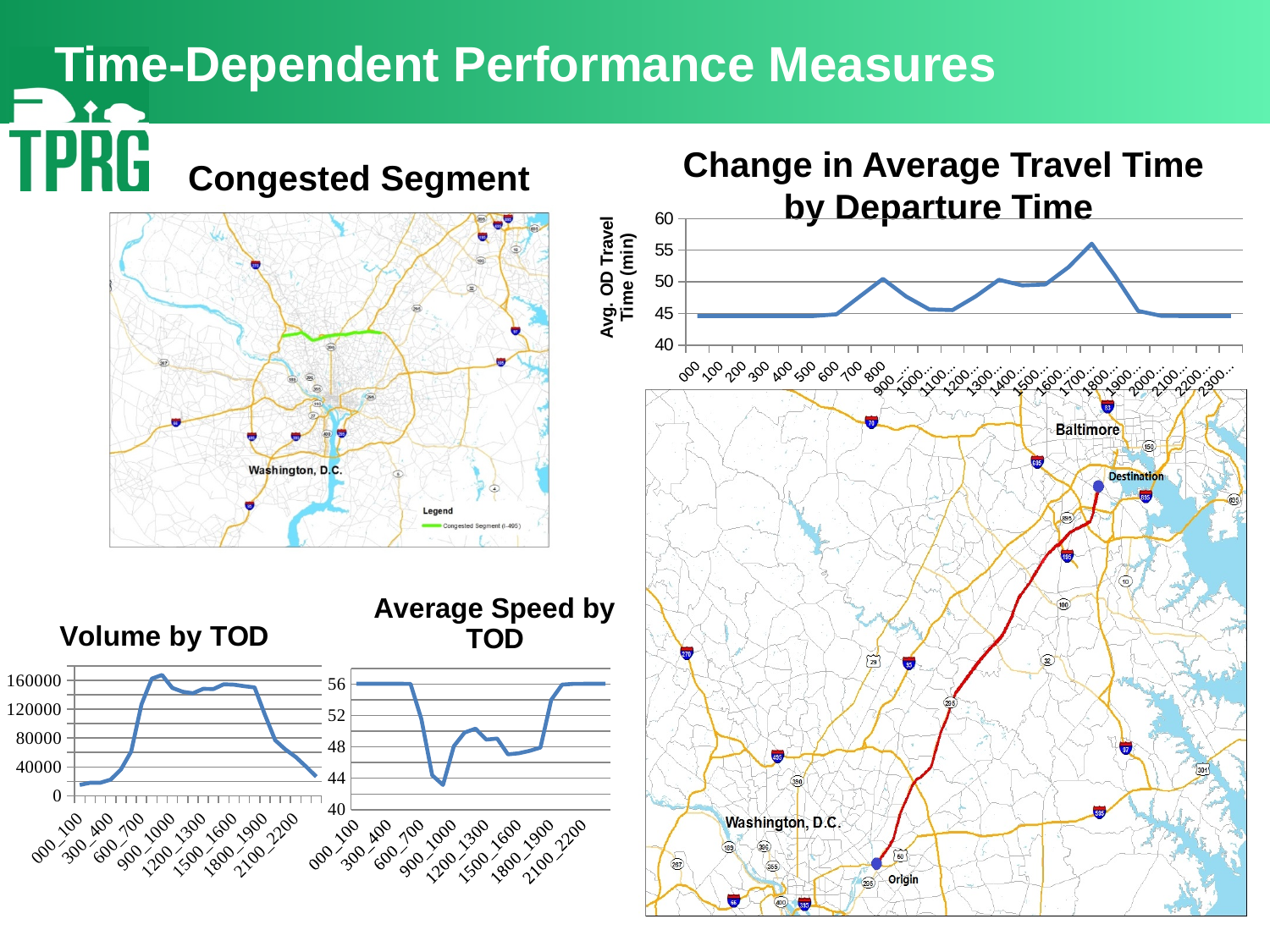
What kind of chart is the 'Change in Average Travel Time by Departure Time' chart? line chart In the 'Volume by TOD' chart, do the values rise or fall from 000_100 to 900_1000? rise In the 'Change in Average Travel Time by Departure Time' chart, is the value for 1900 greater or less than 50? less In the 'Volume by TOD' chart, is the value for 900_1000 greater or less than 160000? less In the 'Average Speed by TOD' chart, is the value for 800_900 greater or less than 44? less How many departure-time points are plotted along the x axis of the 'Change in Average Travel Time by Departure Time' chart? 24 What is the y-axis title of the 'Change in Average Travel Time by Departure Time' chart? Avg. OD Travel Time (min) What kind of chart is the 'Average Speed by TOD' chart? line chart